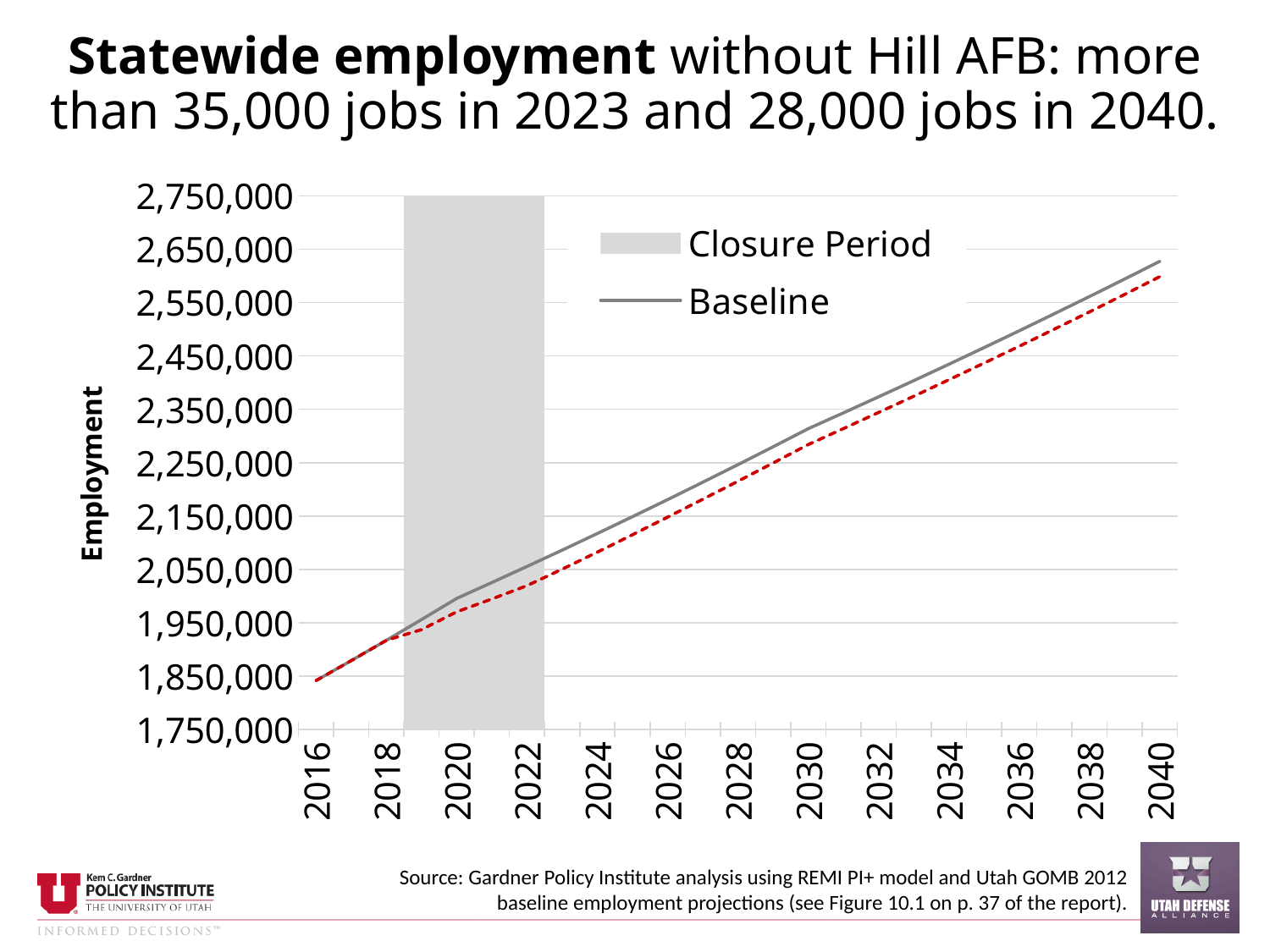
How many entries does the chart legend list? 2 Is the red dashed line's value in 2040 greater or less than 2,550,000? greater Is the Baseline value in 2040 greater or less than 2,550,000? greater What is the label on the vertical axis? Employment Does the Baseline line rise or fall from 2016 to 2040? rise Is the Baseline value in 2030 greater or less than 2,250,000? greater In 2040, which line is higher: the Baseline line or the red dashed line? Baseline How many year labels are shown on the x axis? 13 What kind of chart is shown on the slide? line chart What does the gray shaded area on the chart represent, according to the legend? Closure Period